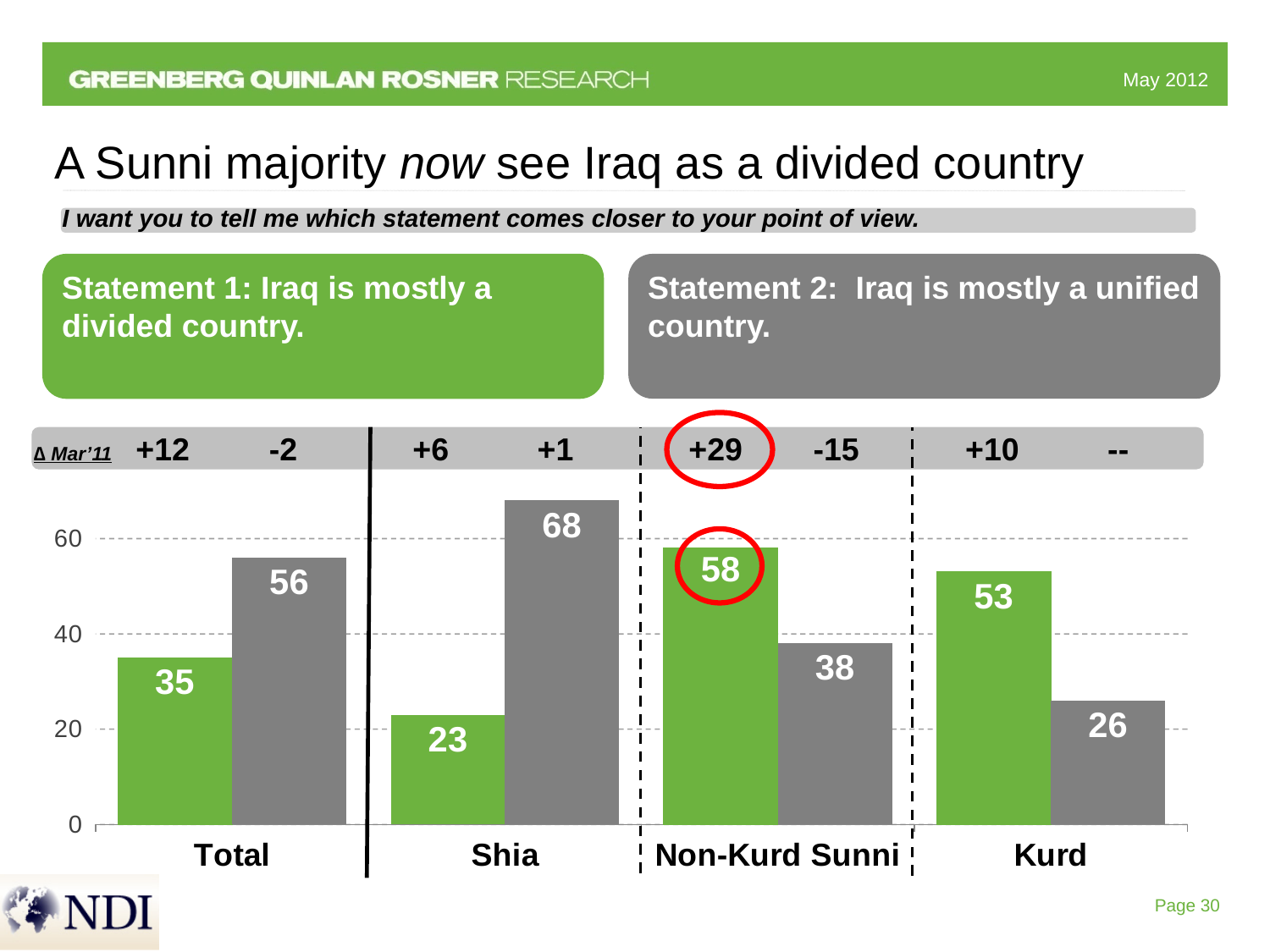
Which colour represents Statement 1 (Iraq is mostly a divided country) in the chart? Green What is the change since March 2011 (Δ Mar'11) shown for Non-Kurd Sunni respondents choosing Statement 1? +29 What percentage of Shia respondents say Iraq is mostly a unified country (Statement 2)? 68 What is the Total value for Statement 1 (Iraq is mostly a divided country)? 35 How many respondent groups are shown on the x axis of the chart? 4 For Non-Kurd Sunni respondents, which is larger: the Statement 1 value or the Statement 2 value? Statement 1 Which group has the highest value for Statement 2 (Iraq is mostly a unified country)? Shia Which group has the lowest value for Statement 1 (Iraq is mostly a divided country)? Shia What kind of chart is shown on the slide? Bar chart What is the value for Non-Kurd Sunni respondents who say Iraq is mostly a divided country (Statement 1)? 58 How many series (statements) are plotted for each group in the chart? 2 What is the difference between the Statement 1 and Statement 2 values for Kurd respondents? 27